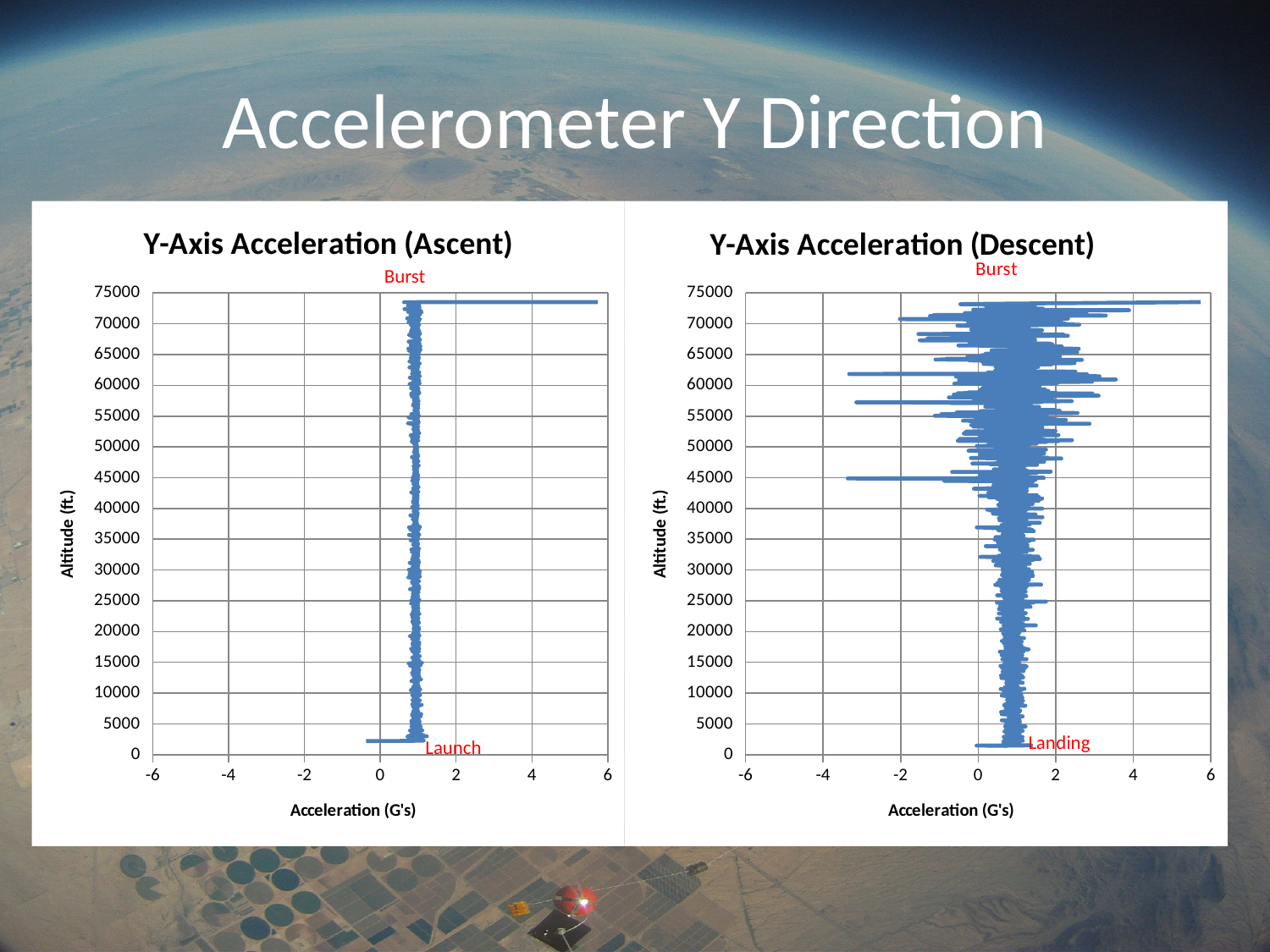
Which chart shows larger swings in acceleration across the flight, the Ascent chart or the Descent chart? Descent chart In the Y-Axis Acceleration (Descent) chart, is the most negative acceleration spike near 45000 ft greater or less than -2 G's? less In the Y-Axis Acceleration (Ascent) chart, is the acceleration for most of the ascent between 5000 and 70000 ft greater or less than 2 G's? less What is the title of the right chart? Y-Axis Acceleration (Descent) In the Y-Axis Acceleration (Descent) chart, what is the lowest value shown on the horizontal axis? -6 What is the title of the left chart? Y-Axis Acceleration (Ascent) How many charts are shown on the slide? 2 In the Y-Axis Acceleration (Ascent) chart, is the peak acceleration at the point labelled Burst greater or less than 4 G's? greater